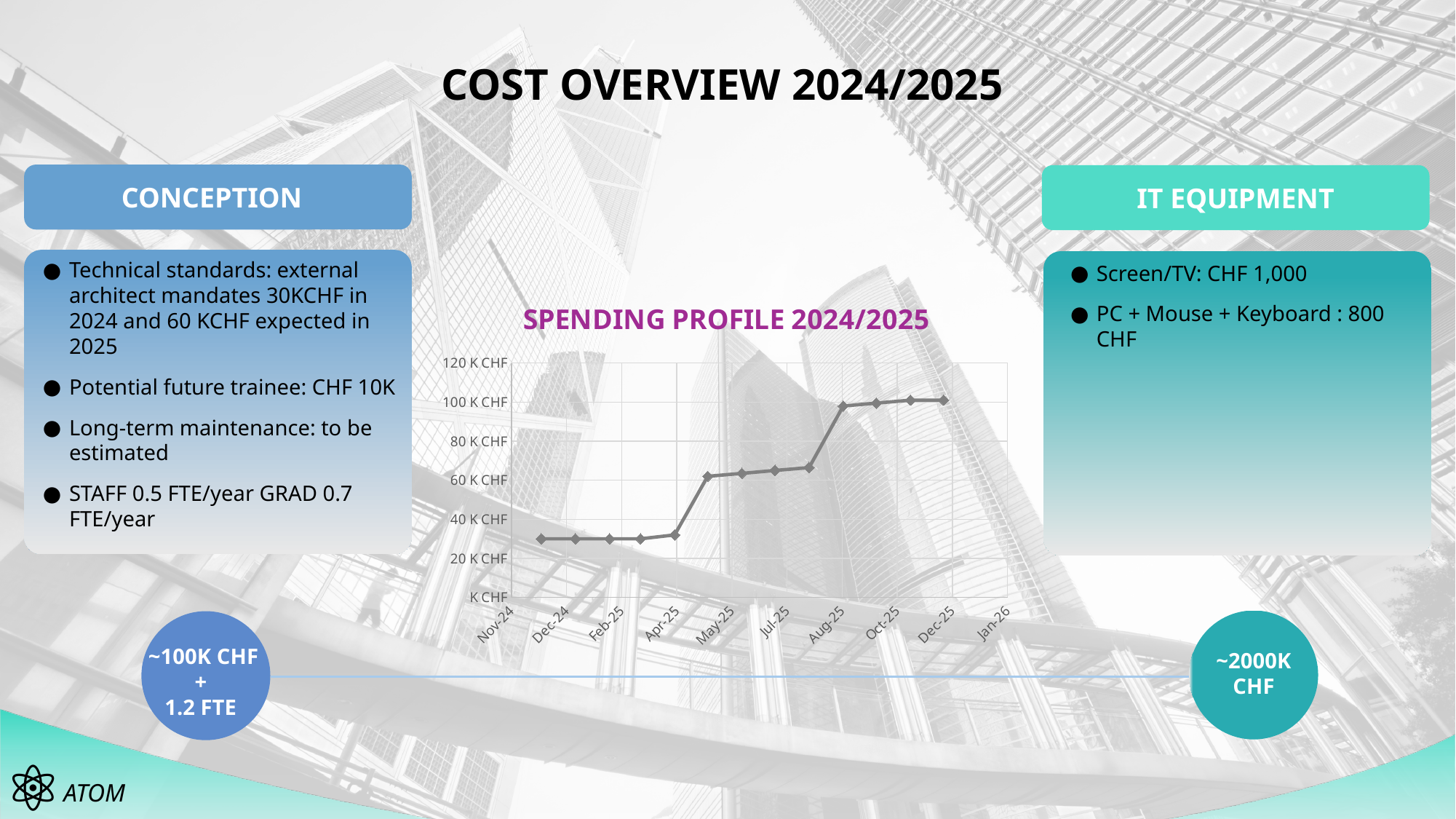
Do the values in the Spending Profile chart rise or fall from Dec-24 to Dec-25? rise Is the value for Aug-25 in the Spending Profile chart greater or less than 80 K CHF? less In the Spending Profile chart, which is larger, the value for Dec-24 or the value for Dec-25? Dec-25 What is the highest value labelled on the y axis of the Spending Profile chart? 120 K CHF What kind of chart is the Spending Profile 2024/2025 chart? line chart Is the value for May-25 in the Spending Profile chart greater or less than 40 K CHF? greater Is the value for Dec-24 in the Spending Profile chart greater or less than 40 K CHF? less In the Spending Profile chart, which is larger, the value for Apr-25 or the value for May-25? May-25 What is the title of the chart on the slide? SPENDING PROFILE 2024/2025